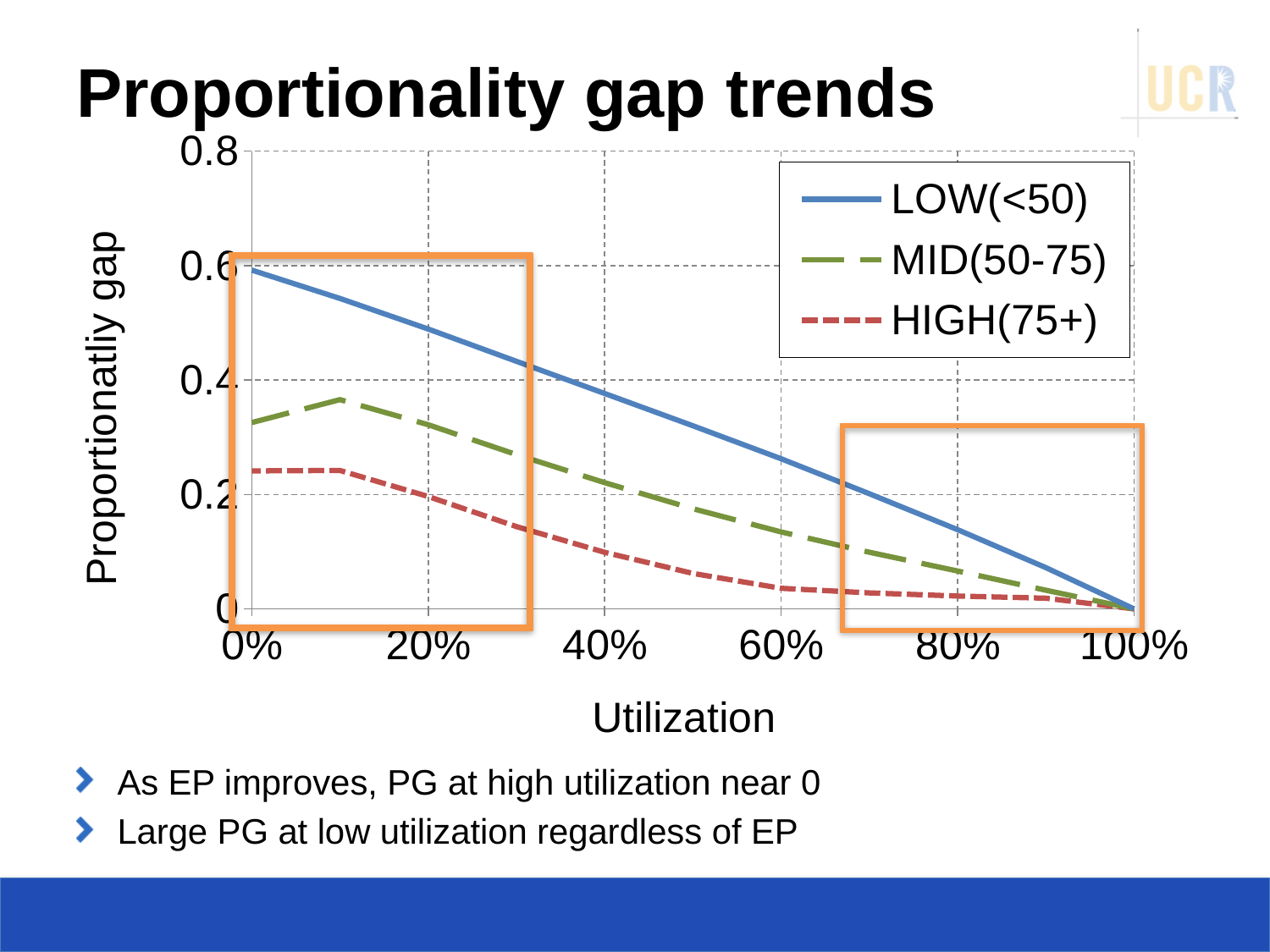
What is the label of the x axis? Utilization Is the value of the MID(50-75) series at 60% utilization greater or less than 0.2? less Is the value of the HIGH(75+) series at 40% utilization greater or less than 0.2? less Does the LOW(<50) series rise or fall as utilization increases from 0% to 100%? fall What is the value of the HIGH(75+) series at 100% utilization? 0 Is the value of the LOW(<50) series at 20% utilization greater or less than 0.4? greater Which series has the lowest value at 40% utilization? HIGH(75+) Which series has the highest value at 20% utilization? LOW(<50) How many series does the legend list? 3 What is the title of the chart? Proportionality gap trends What kind of chart is shown on the slide? line chart